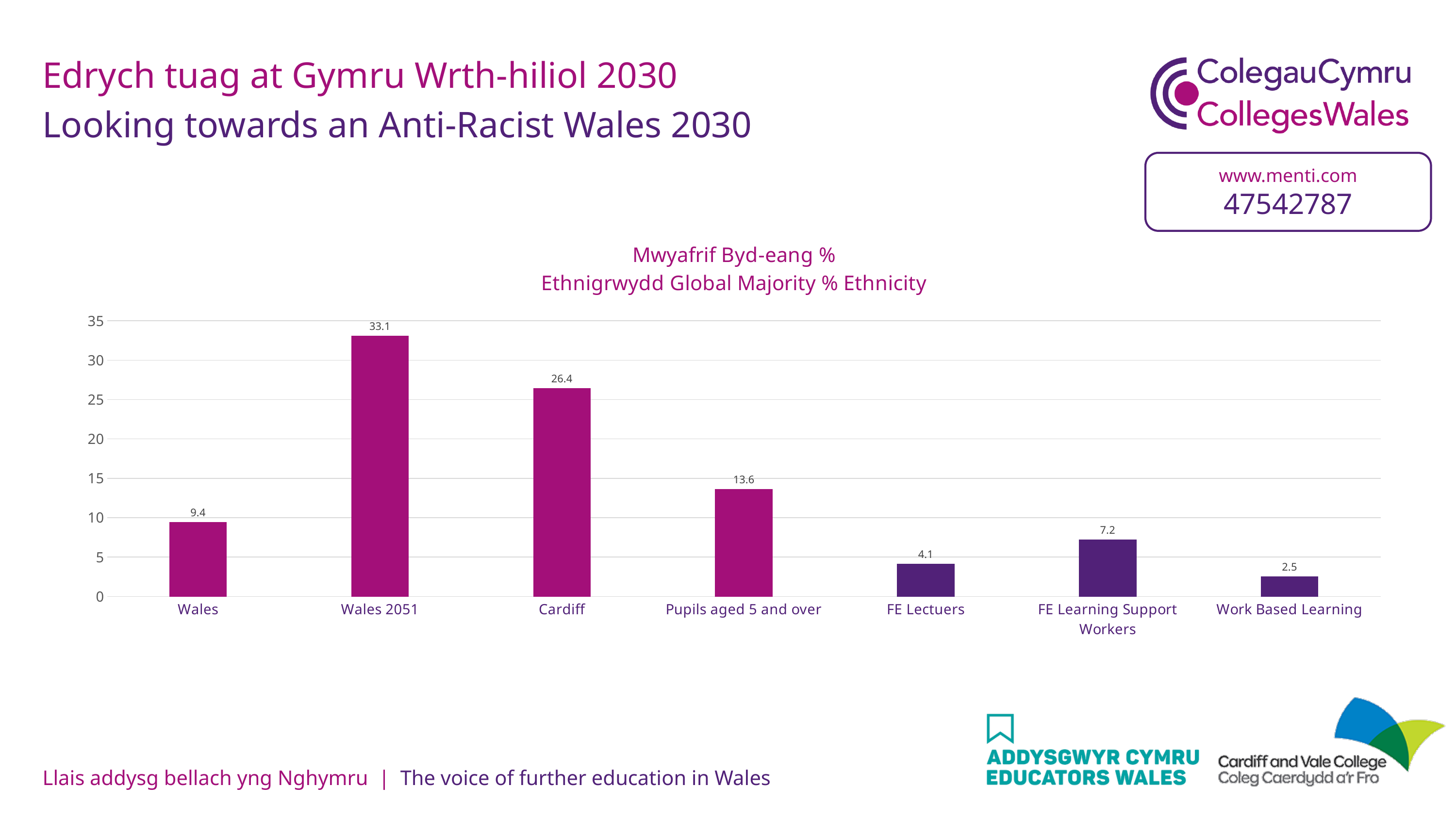
What is the value for Wales 2051? 33.1 What kind of chart is shown on the slide? Bar chart Which category has the highest value? Wales 2051 Which category has the lowest value? Work Based Learning Which is larger, the value for Cardiff or the value for Pupils aged 5 and over? Cardiff What is the difference between the values for FE Learning Support Workers and FE Lectuers? 3.1 What is the title of the chart? Mwyafrif Byd-eang % Ethnigrwydd Global Majority % Ethnicity What is the value for FE Learning Support Workers? 7.2 What is the value for Pupils aged 5 and over? 13.6 How many categories are shown on the x axis? 7 What is the value for Cardiff? 26.4 What is the difference between the values for Wales 2051 and Wales? 23.7